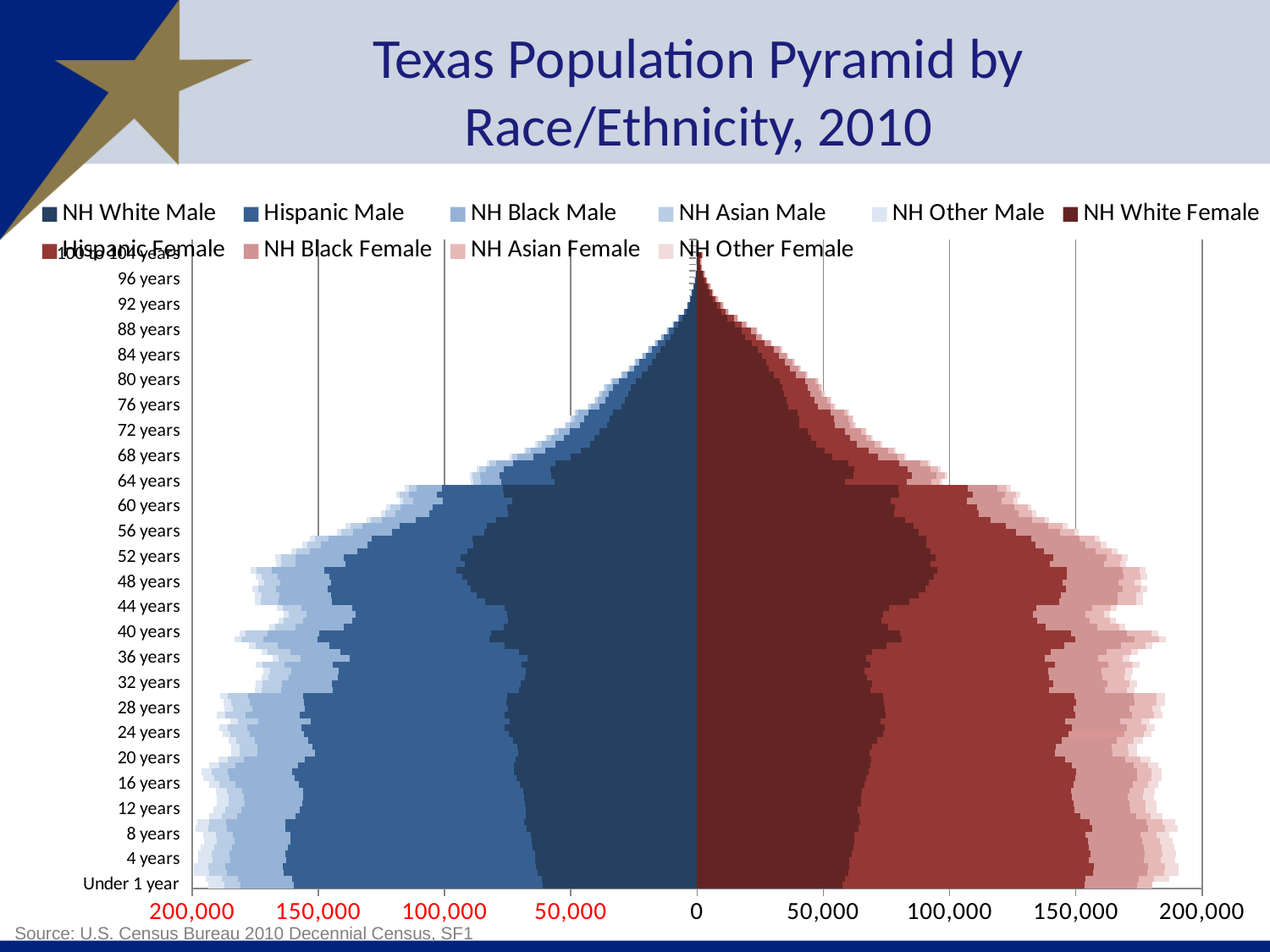
Which age group has a larger total female population, Under 1 year or 96 years? Under 1 year Which age group has a larger total male population, 20 years or 64 years? 20 years What is the title of the chart? Texas Population Pyramid by Race/Ethnicity, 2010 Is the total male population for the 96 years age group greater or less than 50,000? less What source is cited for the chart data? U.S. Census Bureau 2010 Decennial Census, SF1 What kind of chart is shown on the slide? Bar chart (population pyramid) Is the total female population for the Under 1 year age group greater or less than 150,000? greater Is the total male population for the 64 years age group greater or less than 150,000? less How many series does the legend list? 10 As age increases from Under 1 year to 100 to 104 years, do the total bar lengths generally increase or decrease? decrease